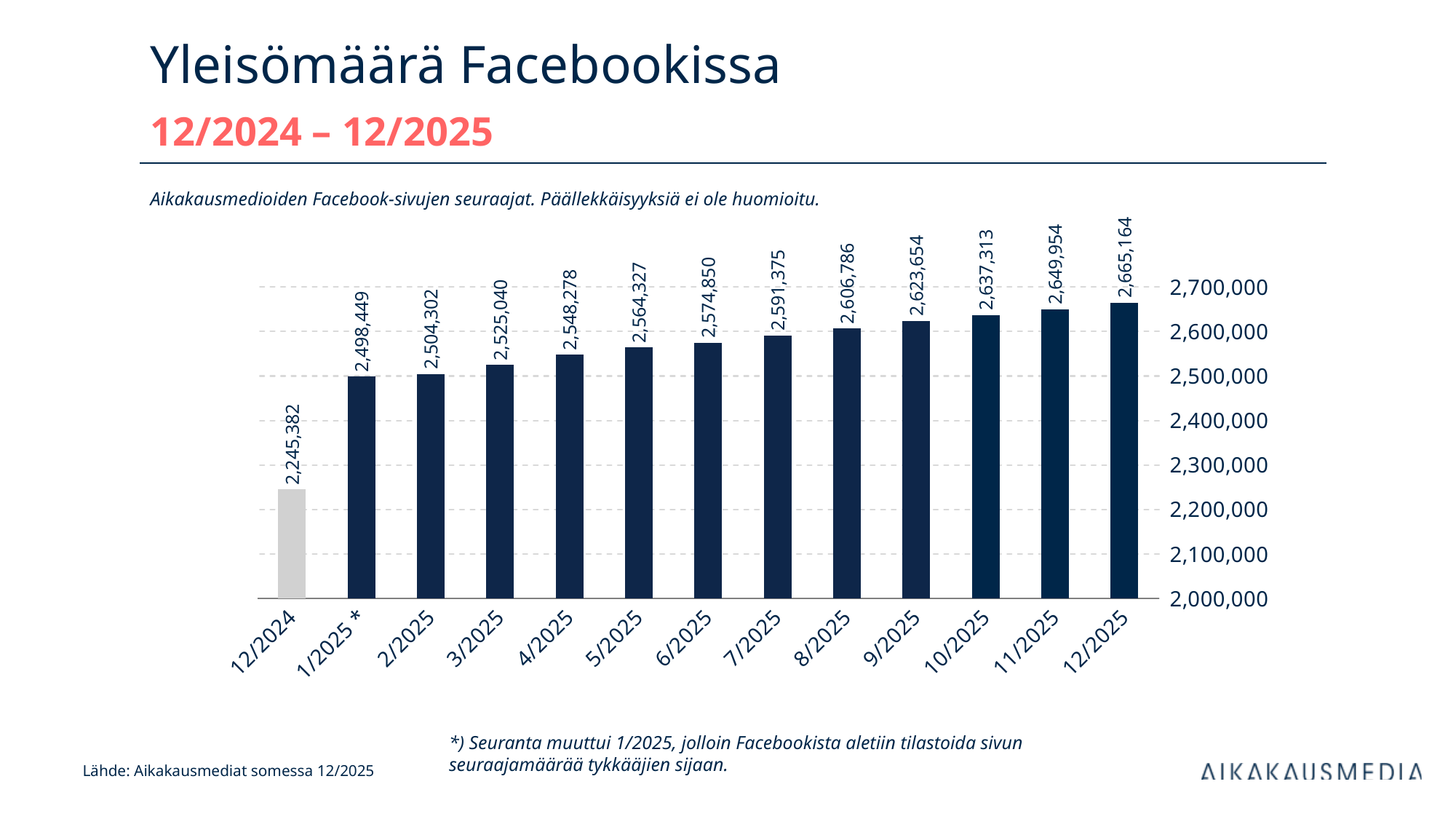
Which month has the highest value? 12/2025 Which is larger, the value for 3/2025 or the value for 9/2025? 9/2025 What is the value for 12/2025? 2,665,164 How many months are shown on the x axis? 13 What is the value for 6/2025? 2,574,850 Which month has the lowest value? 12/2024 Is the value for 12/2024 greater or less than 2,300,000? less What is the difference between the values for 12/2025 and 1/2025? 166,715 Do the values rise or fall from 1/2025 to 12/2025? rise What is the difference between the values for 12/2025 and 12/2024? 419,782 What kind of chart is shown? bar chart What is the value for 12/2024? 2,245,382